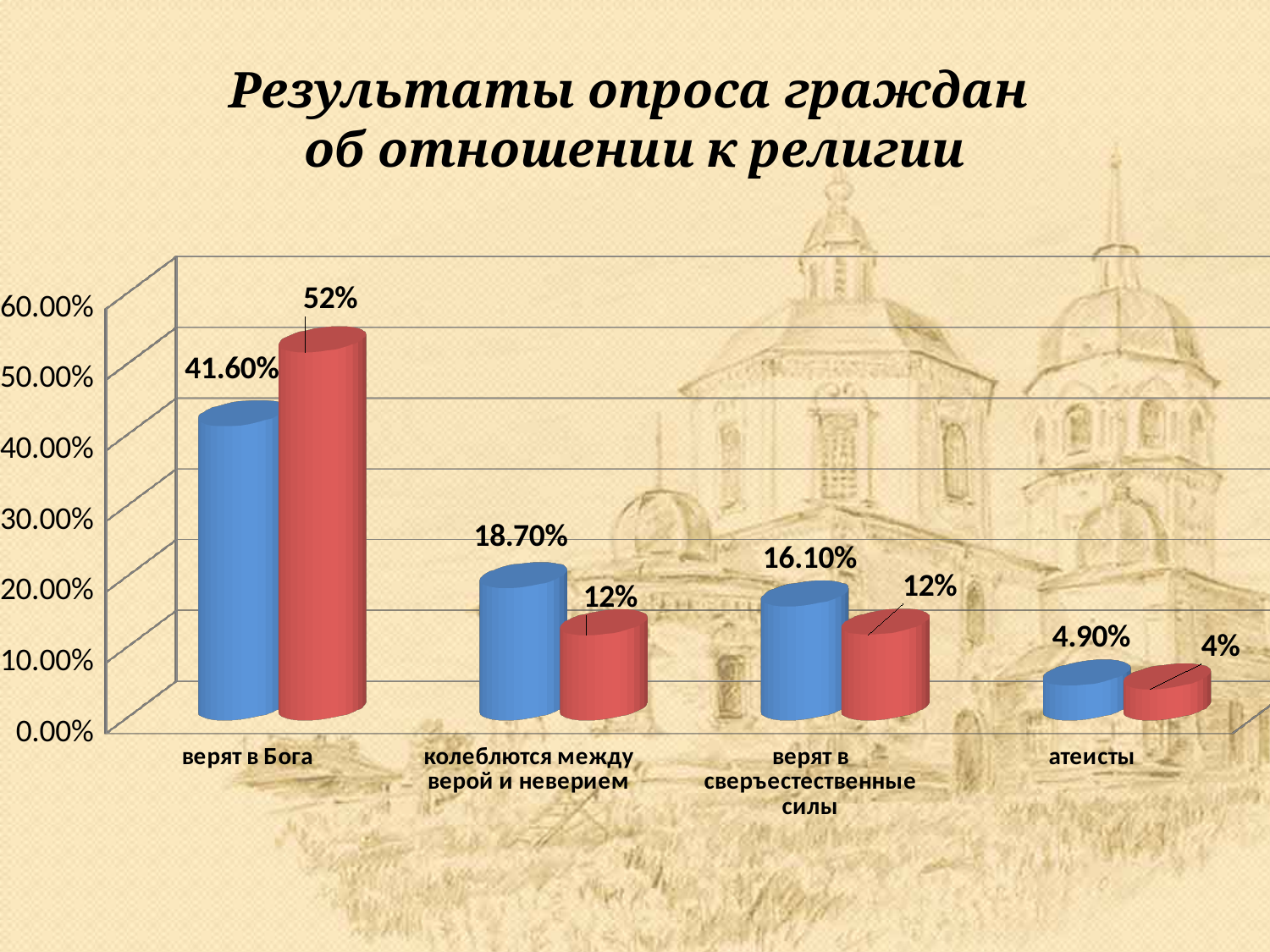
What is the value of the red bar for "верят в Бога"? 52% What is the title of the chart on the slide? Результаты опроса граждан об отношении к религии What is the value of the blue bar for "верят в Бога"? 41.60% How many categories are shown on the x axis? 4 Which category has the highest blue bar? верят в Бога What is the value of the blue bar for "колеблются между верой и неверием"? 18.70% Which category has the lowest red bar? атеисты What kind of chart is shown on the slide? bar chart What is the difference between the red and blue bars for "верят в Бога"? 10.40% Is the blue bar for "верят в сверъестественные силы" greater or less than 20.00%? less For "колеблются между верой и неверием", which bar is larger, the blue or the red? blue What is the value of the red bar for "атеисты"? 4%